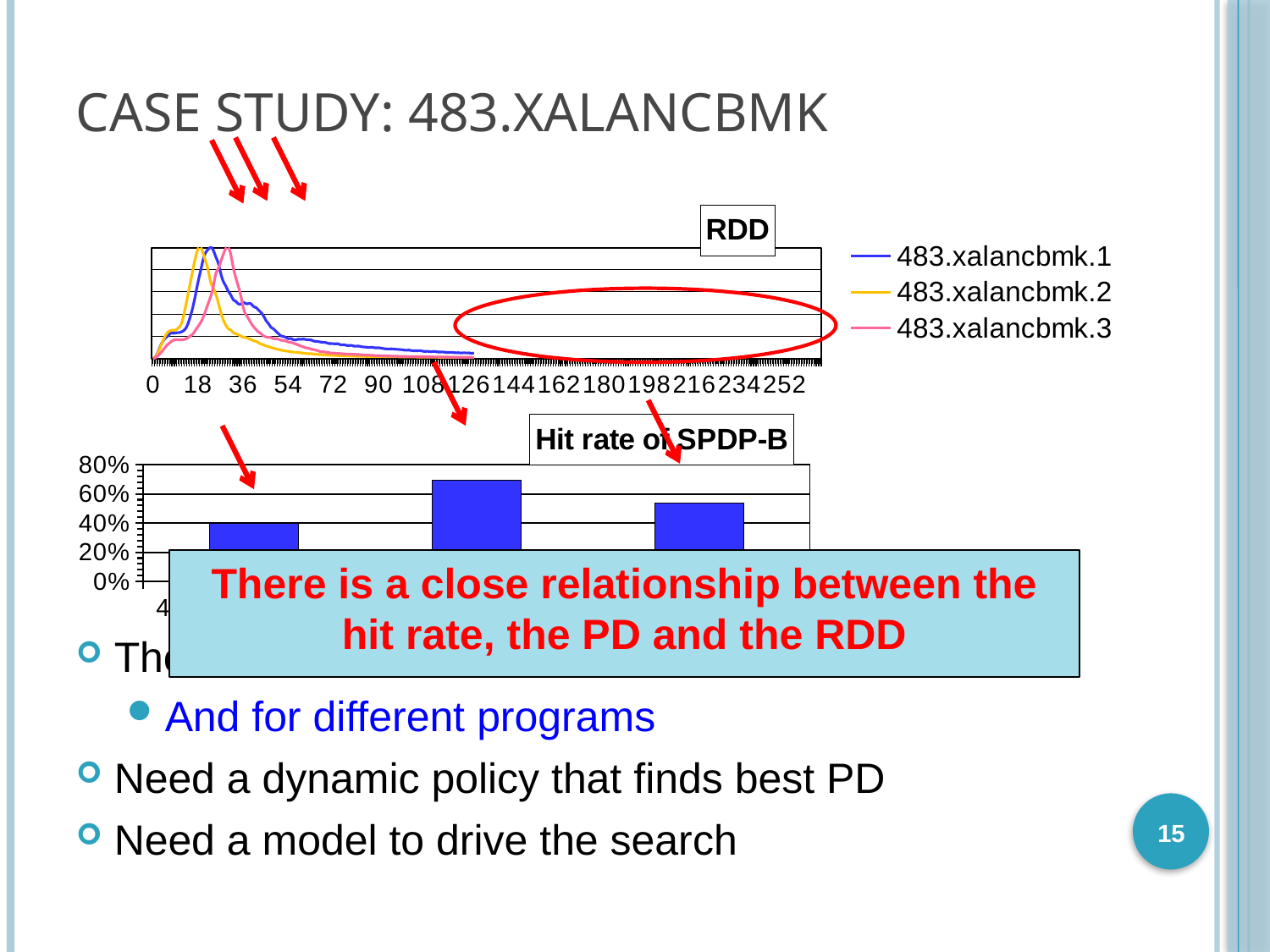
In the Hit rate of SPDP-B chart, which bar is the highest: the left, middle or right one? middle What kind of chart is the Hit rate of SPDP-B chart? bar chart In the RDD chart, which series reaches its peak earliest (furthest left) along the x axis? 483.xalancbmk.2 In the Hit rate of SPDP-B chart, is the value of the left bar greater or less than 60%? less What are the three series named in the legend of the RDD chart? 483.xalancbmk.1, 483.xalancbmk.2, 483.xalancbmk.3 In the Hit rate of SPDP-B chart, is the value of the middle bar greater or less than 60%? greater In the RDD chart, after their peaks, do the lines rise or fall as the x axis increases? fall How many series does the legend of the RDD chart list? 3 In the RDD chart, which series has its peak furthest to the right along the x axis? 483.xalancbmk.3 What kind of chart is the RDD chart? line chart In the Hit rate of SPDP-B chart, which is larger, the left bar or the right bar? right bar How many bars are plotted in the Hit rate of SPDP-B chart? 3